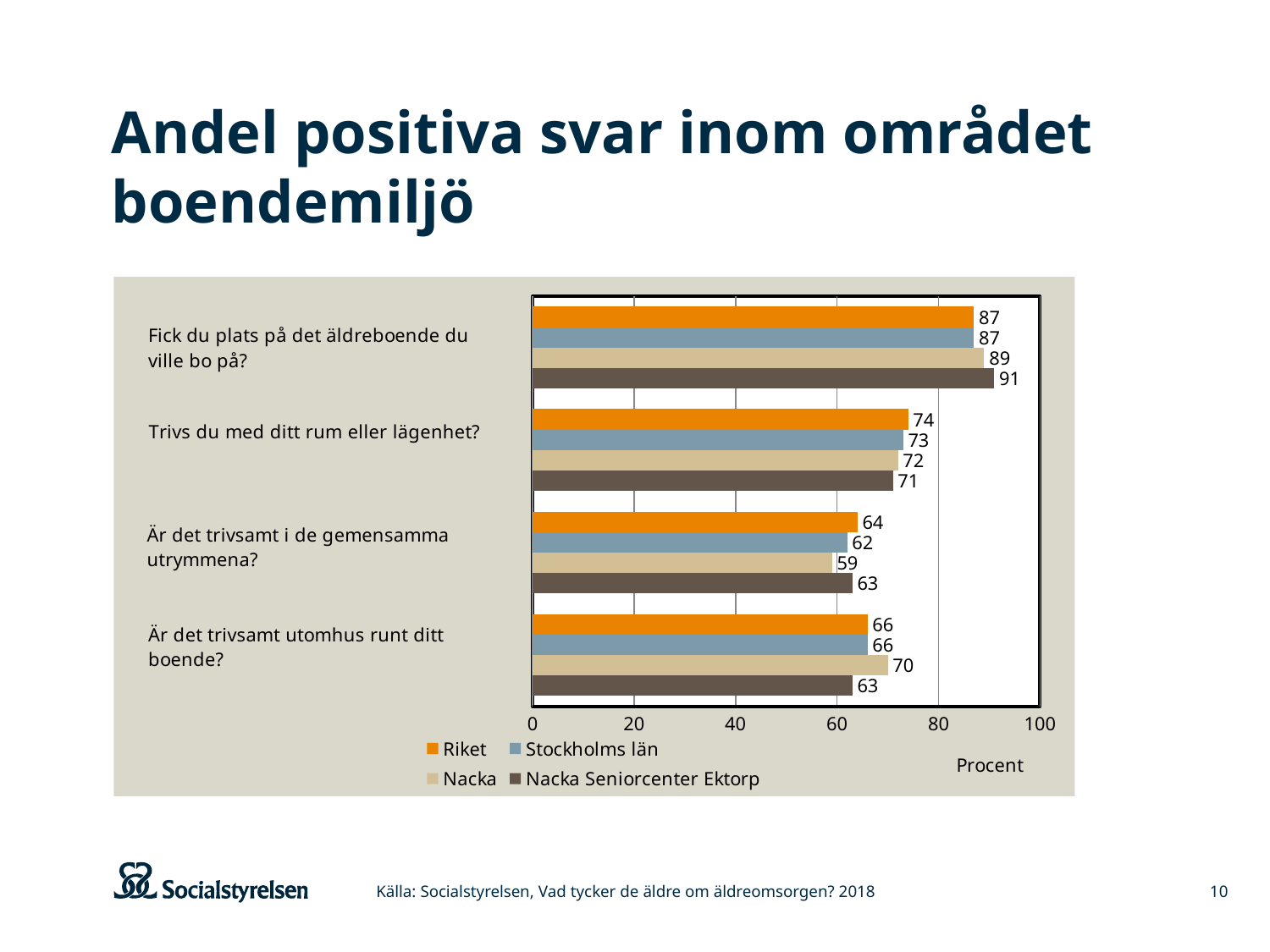
What is the value for Nacka Seniorcenter Ektorp on "Fick du plats på det äldreboende du ville bo på?"? 91 Which is larger on "Är det trivsamt utomhus runt ditt boende?": Nacka or Nacka Seniorcenter Ektorp? Nacka What kind of chart is shown on the slide? Bar chart Which series has the lowest value on "Är det trivsamt i de gemensamma utrymmena?"? Nacka How many series does the legend list? 4 Is the value for Riket on "Trivs du med ditt rum eller lägenhet?" greater or less than 60? greater What is the value for Riket on "Är det trivsamt i de gemensamma utrymmena?"? 64 Which series has the highest value on "Fick du plats på det äldreboende du ville bo på?"? Nacka Seniorcenter Ektorp What is the difference between Nacka Seniorcenter Ektorp and Riket on "Fick du plats på det äldreboende du ville bo på?"? 4 What is the value for Nacka on "Är det trivsamt utomhus runt ditt boende?"? 70 How many question categories are shown on the chart? 4 What is the value for Stockholms län on "Trivs du med ditt rum eller lägenhet?"? 73